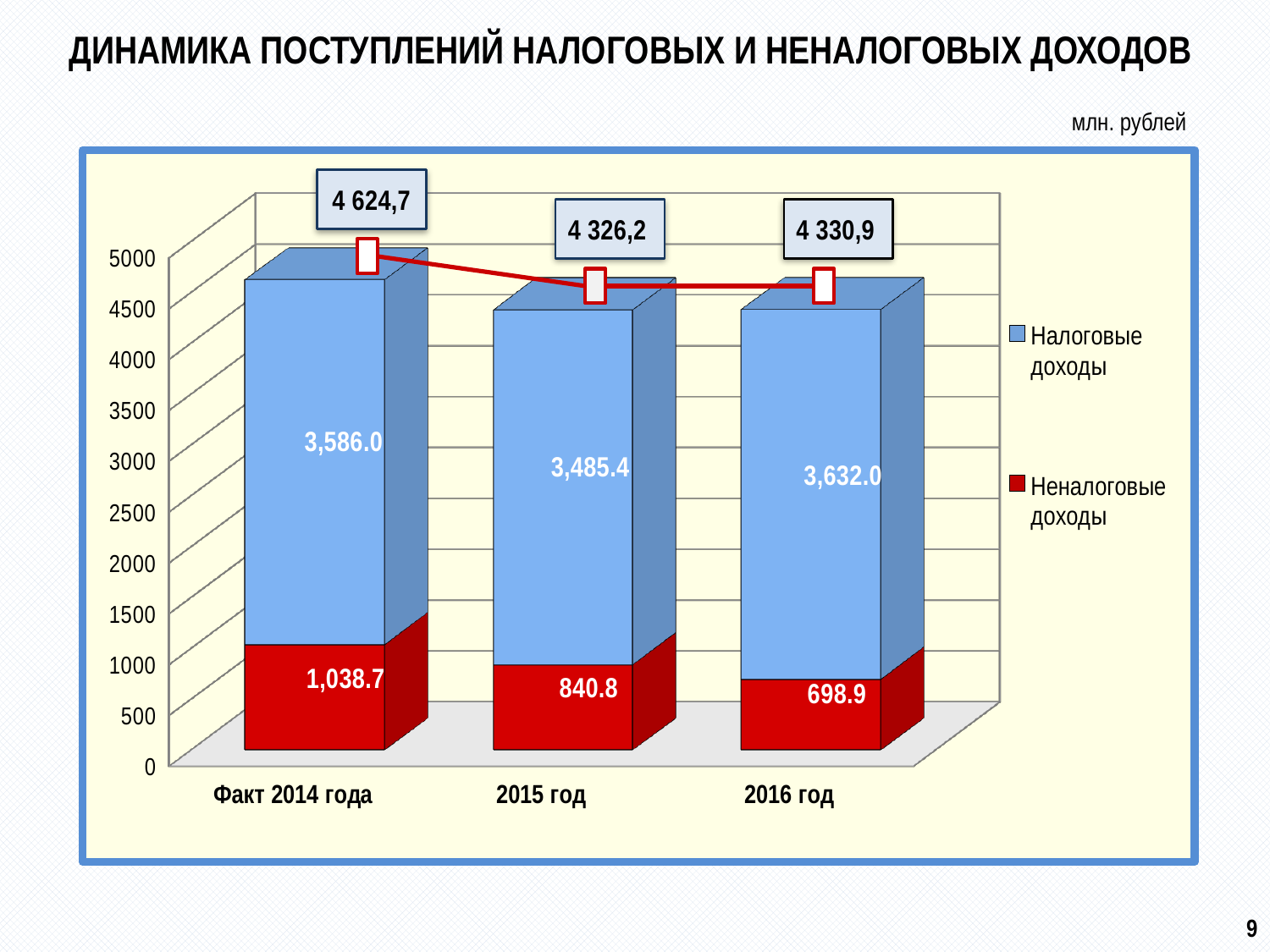
What is the difference between Неналоговые доходы for Факт 2014 года and 2016 год? 339.8 How many categories are shown on the x axis? 3 How many series does the legend list? 2 What is the value of Налоговые доходы for 2015 год? 3,485.4 Which is larger: the total for 2015 год or the total for 2016 год? 2016 год How do the values of Неналоговые доходы change from Факт 2014 года to 2016 год? They fall Which category has the lowest value for Неналоговые доходы? 2016 год What is the value of Неналоговые доходы for Факт 2014 года? 1,038.7 What type of chart is shown on the slide? Stacked bar chart Which category has the highest value for Налоговые доходы? 2016 год What unit is indicated above the chart? млн. рублей What is the total shown above the bar for 2016 год? 4 330,9